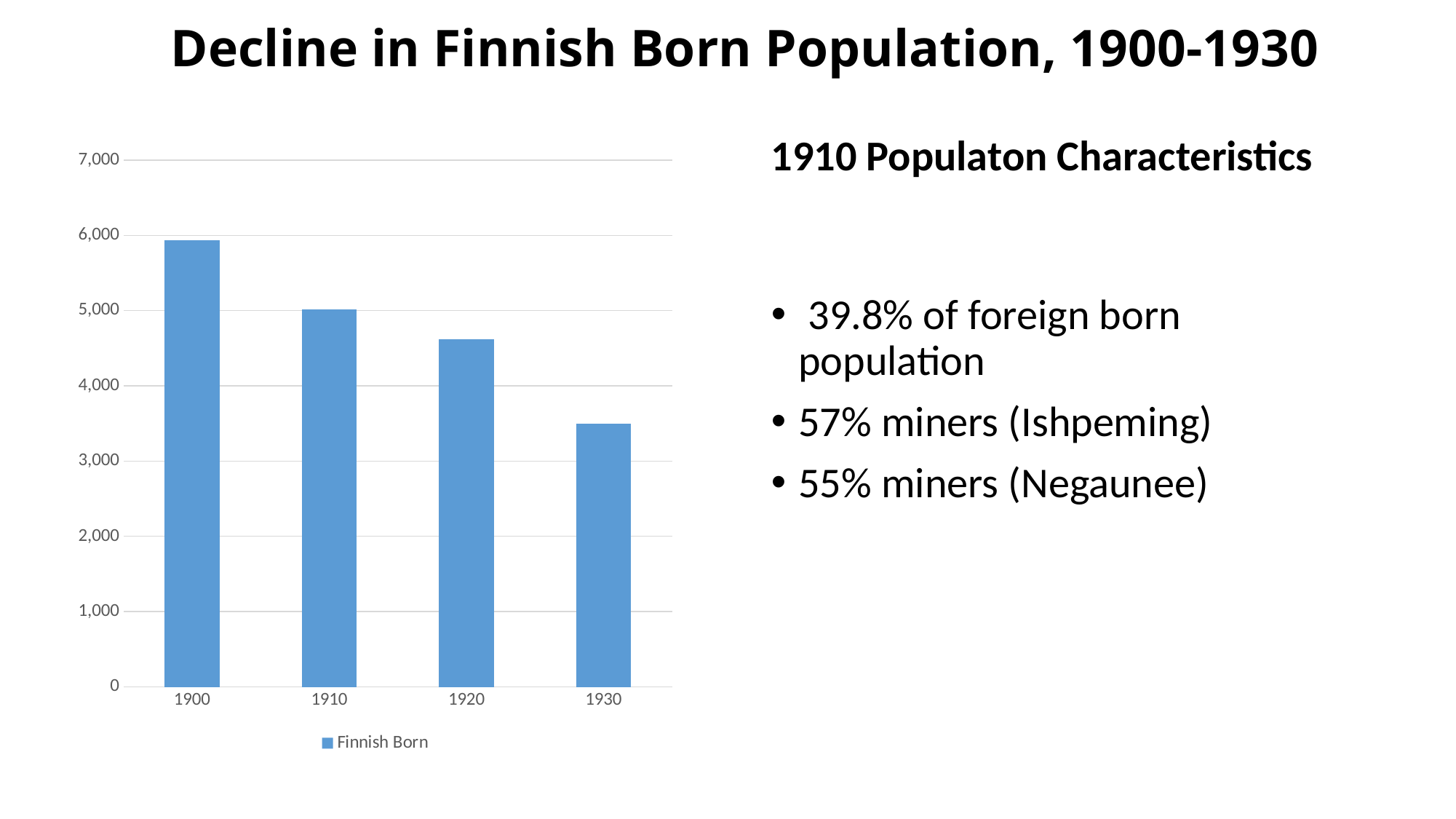
Which year has the lowest Finnish Born value? 1930 What series name is shown in the chart legend? Finnish Born Is the Finnish Born value for 1900 greater or less than 5,000? greater Is the Finnish Born value for 1930 greater or less than 4,000? less How many years are plotted on the x axis of the chart? 4 What is the title of the slide containing the chart? Decline in Finnish Born Population, 1900-1930 Which is larger, the Finnish Born value for 1910 or for 1920? 1910 Do the Finnish Born values rise or fall from 1900 to 1930? fall What kind of chart is shown on the slide? bar chart Which year has the highest Finnish Born value? 1900 How many series does the chart legend list? 1 Is the Finnish Born value for 1920 greater or less than 4,000? greater